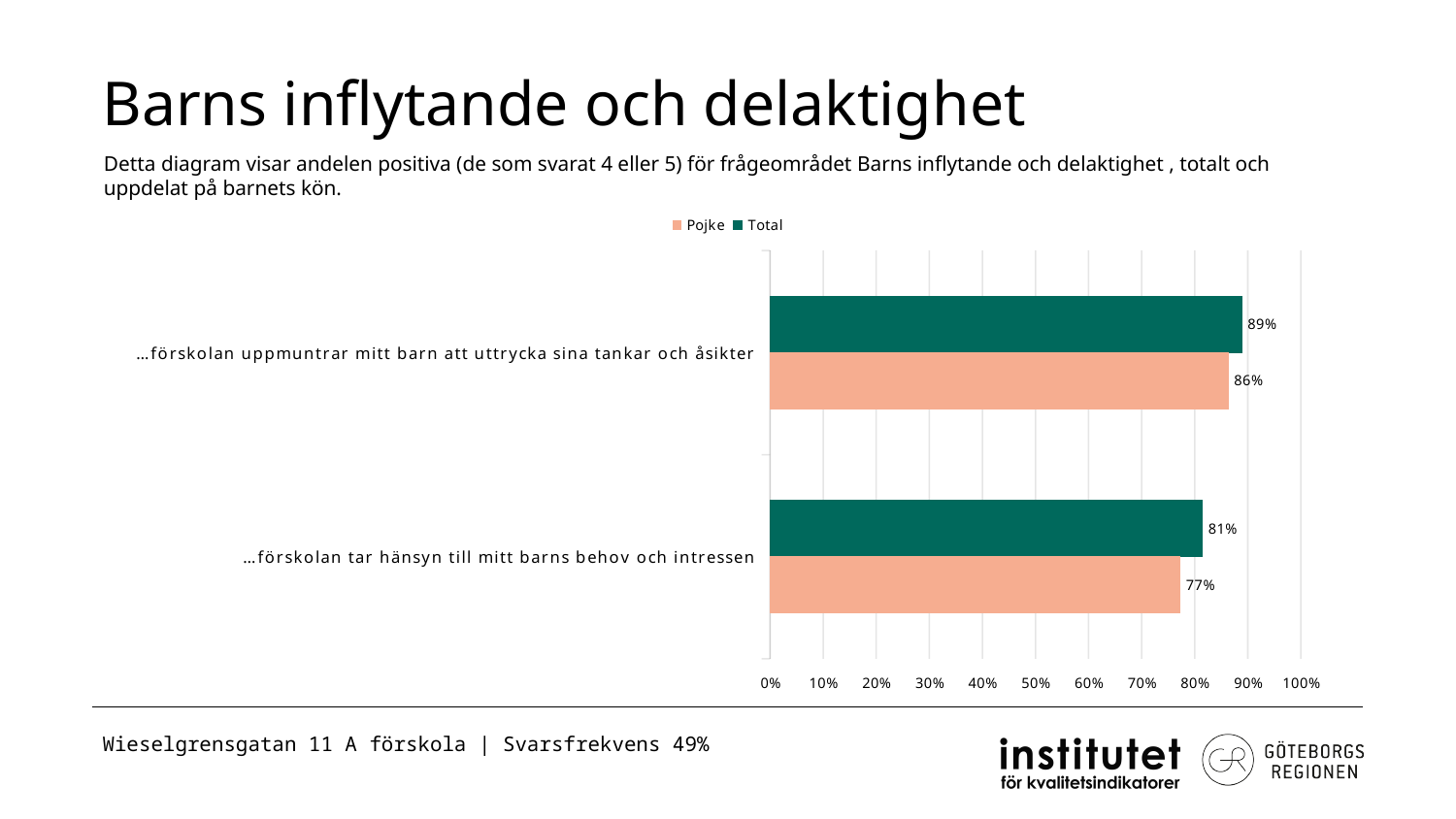
What is the Total value for "…förskolan tar hänsyn till mitt barns behov och intressen"? 81% How many categories are shown in the chart? 2 What kind of chart is shown on the slide? Bar chart What is the difference between the Total and Pojke values for "…förskolan tar hänsyn till mitt barns behov och intressen"? 4 percentage points What is the Pojke value for "…förskolan tar hänsyn till mitt barns behov och intressen"? 77% For "…förskolan uppmuntrar mitt barn att uttrycka sina tankar och åsikter", which is larger, the Pojke value or the Total value? Total Which category has the lowest Pojke value? …förskolan tar hänsyn till mitt barns behov och intressen Which category has the highest Total value? …förskolan uppmuntrar mitt barn att uttrycka sina tankar och åsikter What is the Pojke value for "…förskolan uppmuntrar mitt barn att uttrycka sina tankar och åsikter"? 86% How many series does the legend list? 2 What is the Total value for "…förskolan uppmuntrar mitt barn att uttrycka sina tankar och åsikter"? 89% What is the difference between the Pojke values for the two categories? 9 percentage points